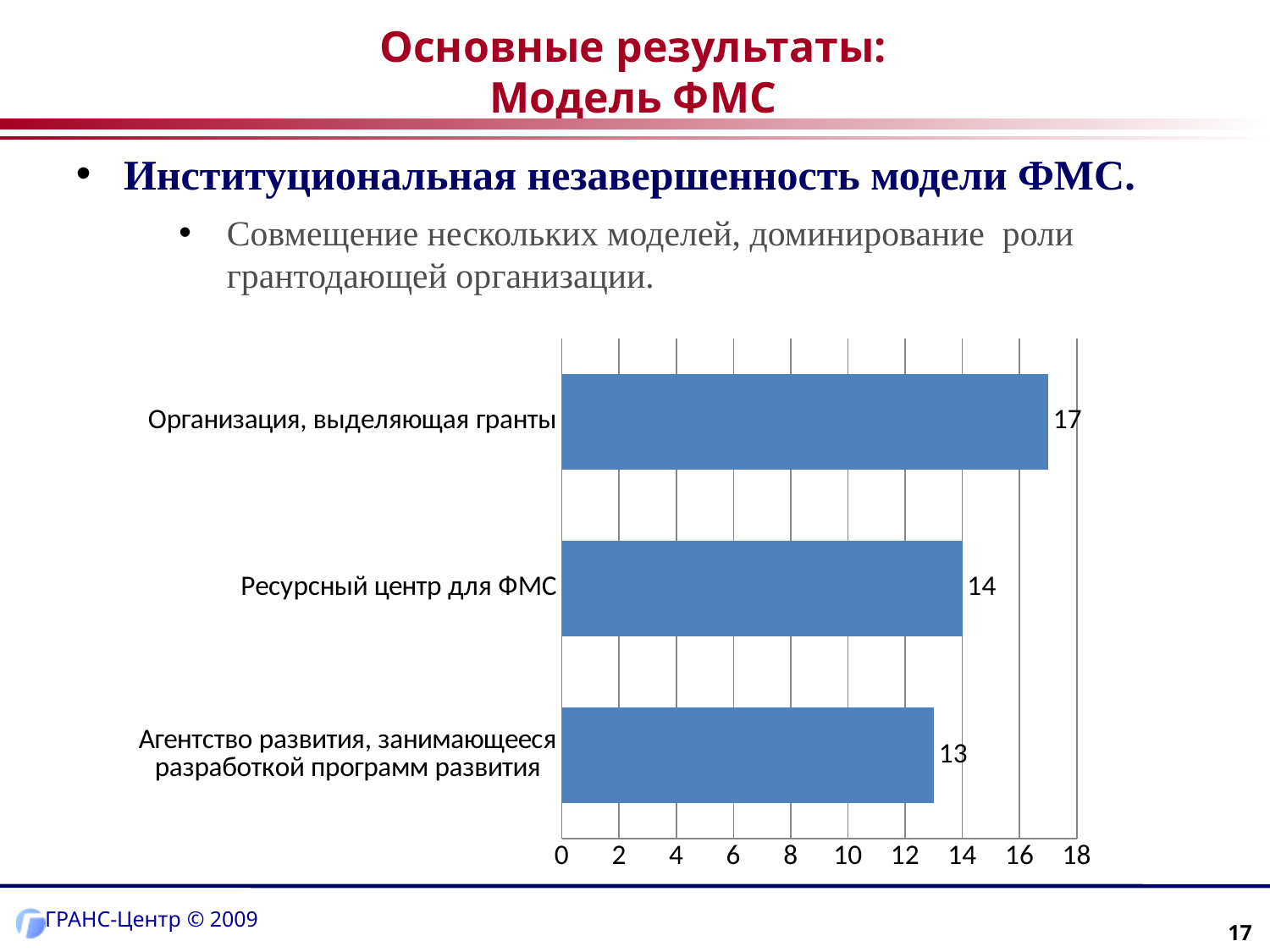
What kind of chart is shown on the slide? bar chart Which category has the lowest value? Агентство развития, занимающееся разработкой программ развития What is the value for Организация, выделяющая гранты? 17 Is the value for Организация, выделяющая гранты greater or less than 16? greater Which category has the highest value? Организация, выделяющая гранты What is the difference between the values for Ресурсный центр для ФМС and Агентство развития, занимающееся разработкой программ развития? 1 What is the difference between the values for Организация, выделяющая гранты and Ресурсный центр для ФМС? 3 What is the value for Агентство развития, занимающееся разработкой программ развития? 13 What is the value for Ресурсный центр для ФМС? 14 Which is larger: the value for Организация, выделяющая гранты or the value for Агентство развития, занимающееся разработкой программ развития? Организация, выделяющая гранты How many categories are shown in the chart? 3 What is the maximum value shown on the horizontal axis? 18